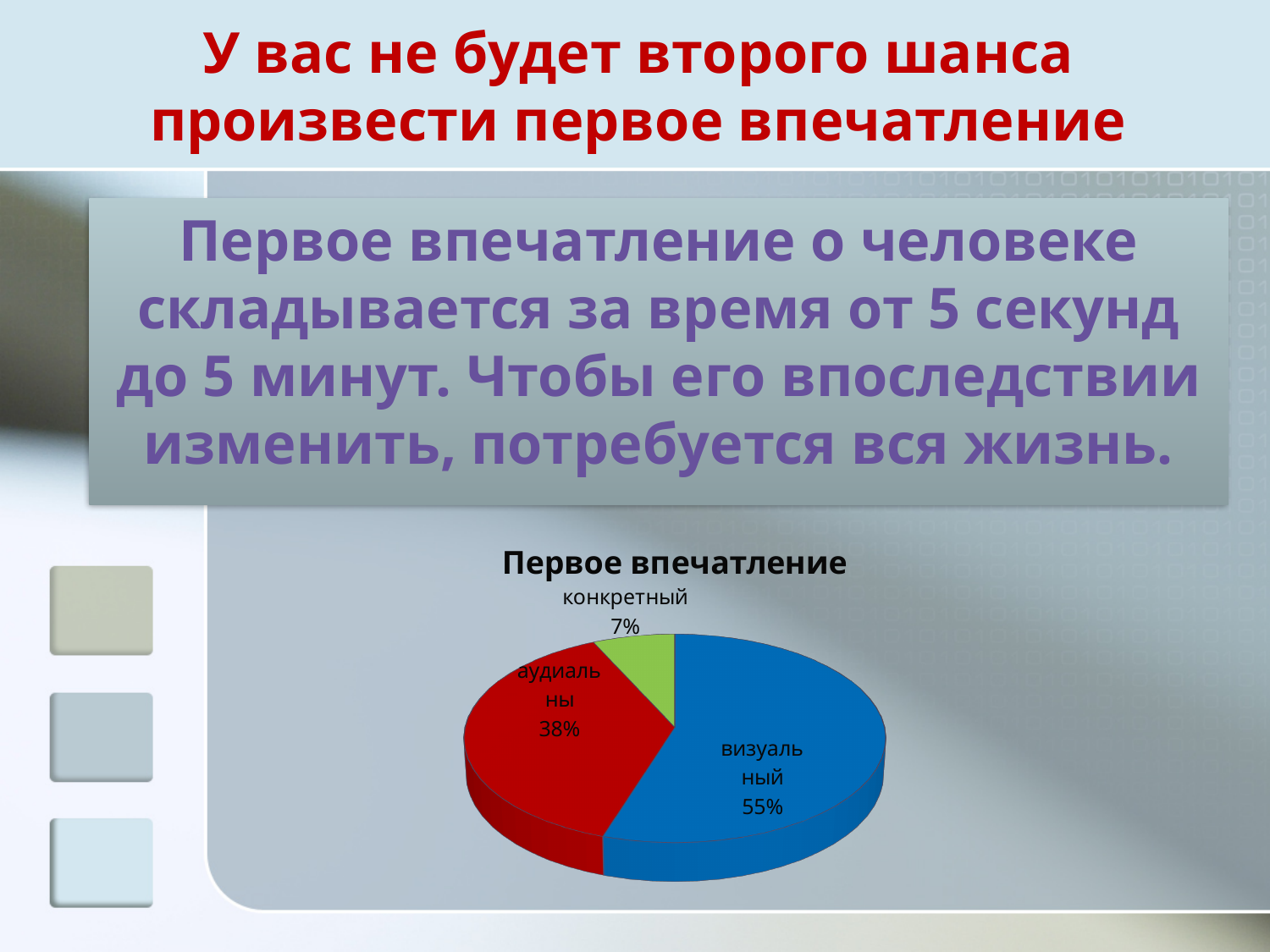
What is the difference in percentage points between the визуальный and аудиальны slices? 17 Which is larger, the аудиальны slice or the конкретный slice? аудиальны What is the title of the chart? Первое впечатление What percentage does the конкретный slice show? 7% How many slices does the pie chart have? 3 What percentage does the визуальный slice show? 55% Which slice of the pie is the largest? визуальный What percentage does the аудиальны slice show? 38% What colour is the визуальный slice? blue What is the combined share of the аудиальны and конкретный slices? 45% What kind of chart is shown on the slide? pie chart Which slice of the pie is the smallest? конкретный